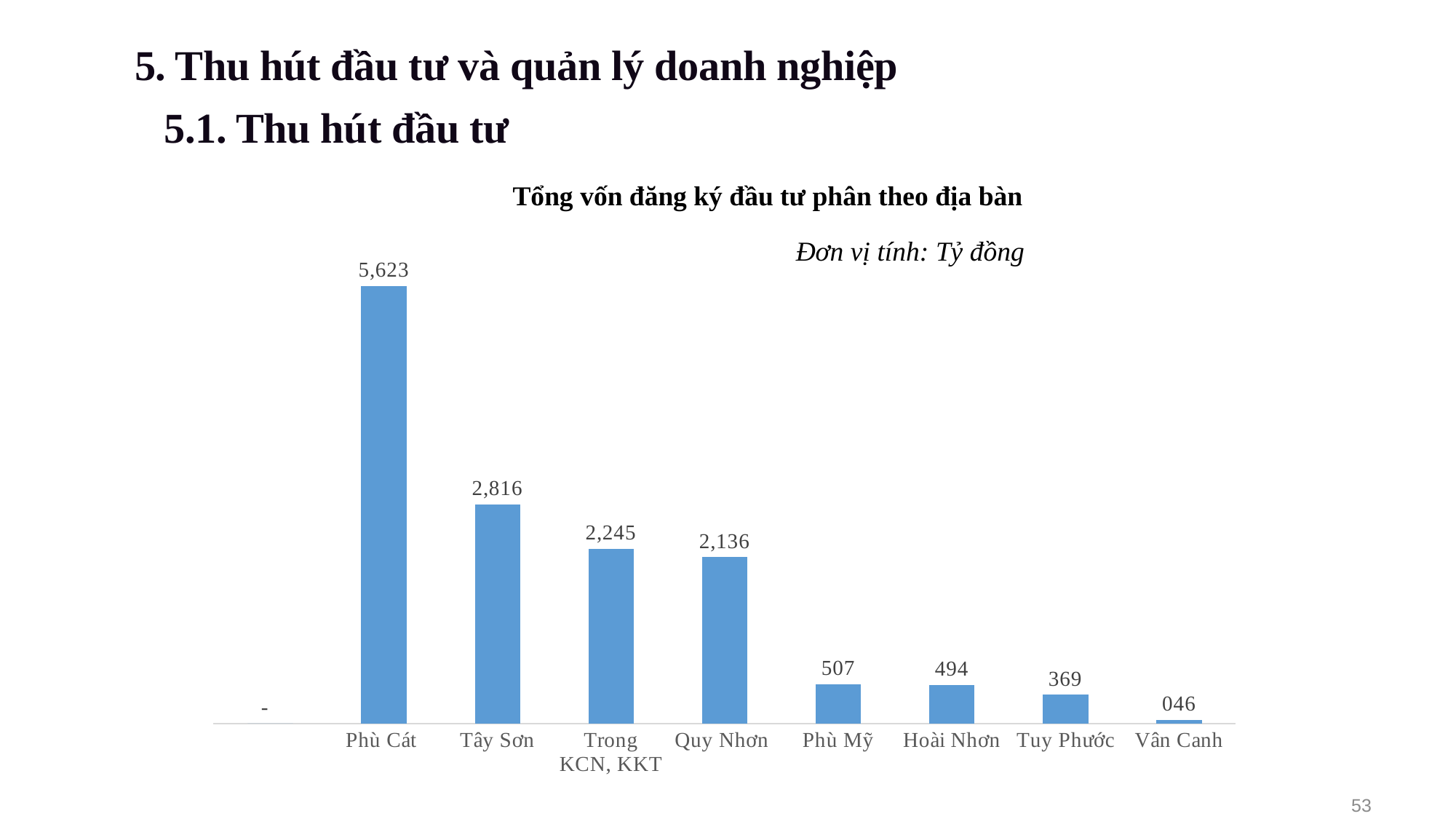
What is the difference between the values for Phù Mỹ and Hoài Nhơn? 13 What is the value for Trong KCN, KKT? 2,245 What is the title of the chart? Tổng vốn đăng ký đầu tư phân theo địa bàn How many categories are shown on the x axis? 8 What is the difference between the values for Phù Cát and Tây Sơn? 2,807 Which category has the highest value? Phù Cát Which category has the lowest value? Vân Canh What is the value for Hoài Nhơn? 494 Which is larger, the value for Trong KCN, KKT or the value for Quy Nhơn? Trong KCN, KKT What is the value for Phù Cát? 5,623 What kind of chart is this? bar chart What is the value for Tây Sơn? 2,816